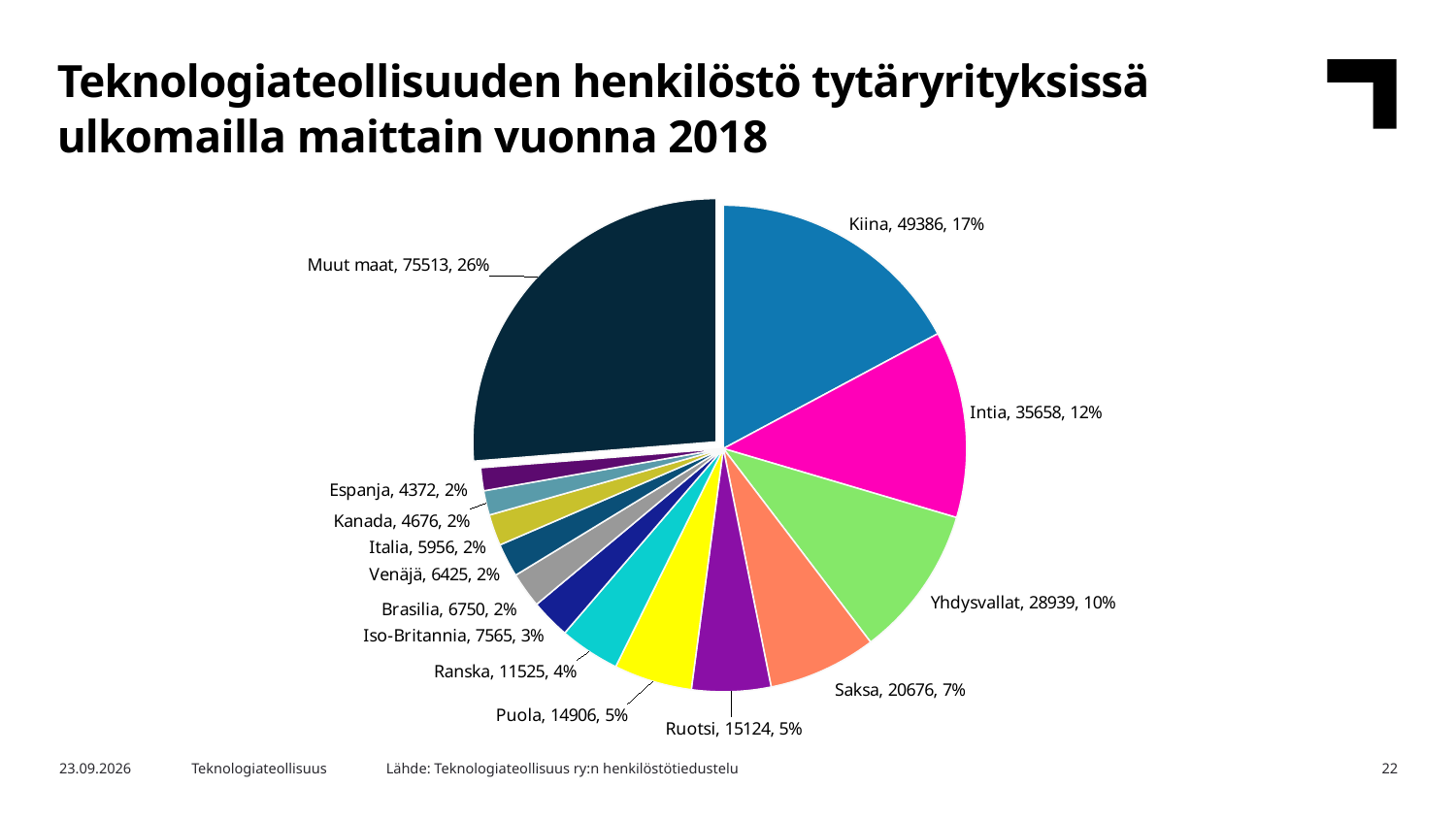
Which slice is the smallest in the pie chart? Espanja How many slices does the pie chart have? 14 What is the value for Yhdysvallat? 28939 Which is larger, the value for Saksa or the value for Ruotsi? Saksa What is the value for Iso-Britannia? 7565 What is the difference between the values for Kiina and Intia? 13728 What is the value for Kiina? 49386 Which slice is the largest in the pie chart? Muut maat What is the title of the chart? Teknologiateollisuuden henkilöstö tytäryrityksissä ulkomailla maittain vuonna 2018 What type of chart is shown on the slide? Pie chart What share of the pie does Intia represent? 12% What share of the pie does Muut maat represent? 26%